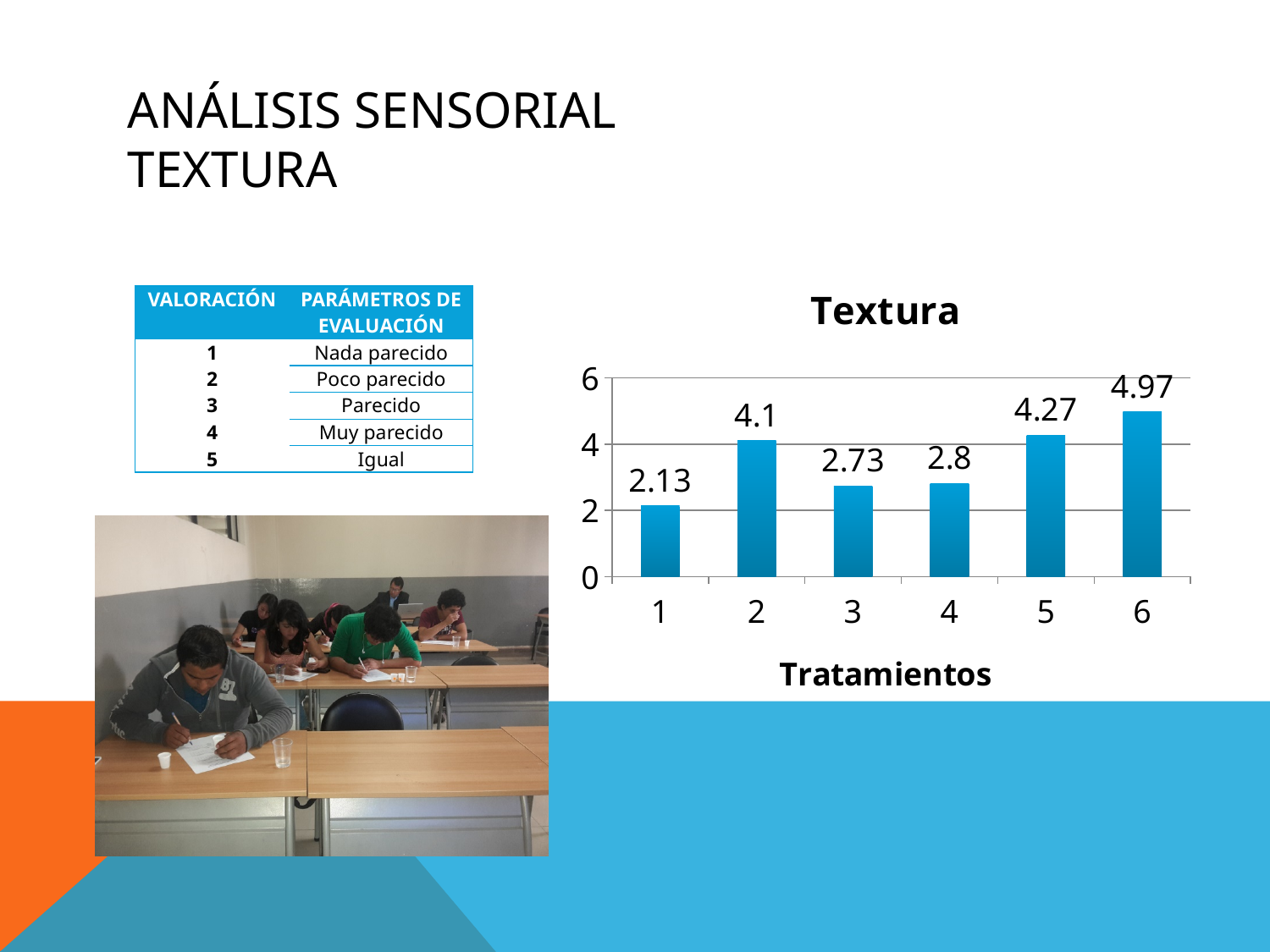
What is the value for treatment 1 in the Textura chart? 2.13 How many treatments are shown in the Textura chart? 6 What is the x-axis title of the Textura chart? Tratamientos What is the difference between the values for treatment 2 and treatment 3 in the Textura chart? 1.37 What is the difference between the values for treatment 6 and treatment 1 in the Textura chart? 2.84 What is the value for treatment 3 in the Textura chart? 2.73 Which treatment has the lowest value in the Textura chart? 1 Is the value for treatment 4 in the Textura chart greater or less than 4? less Which treatment has the highest value in the Textura chart? 6 Which has a larger value in the Textura chart, treatment 2 or treatment 5? Treatment 5 What kind of chart is the Textura chart? Bar chart What is the value for treatment 6 in the Textura chart? 4.97